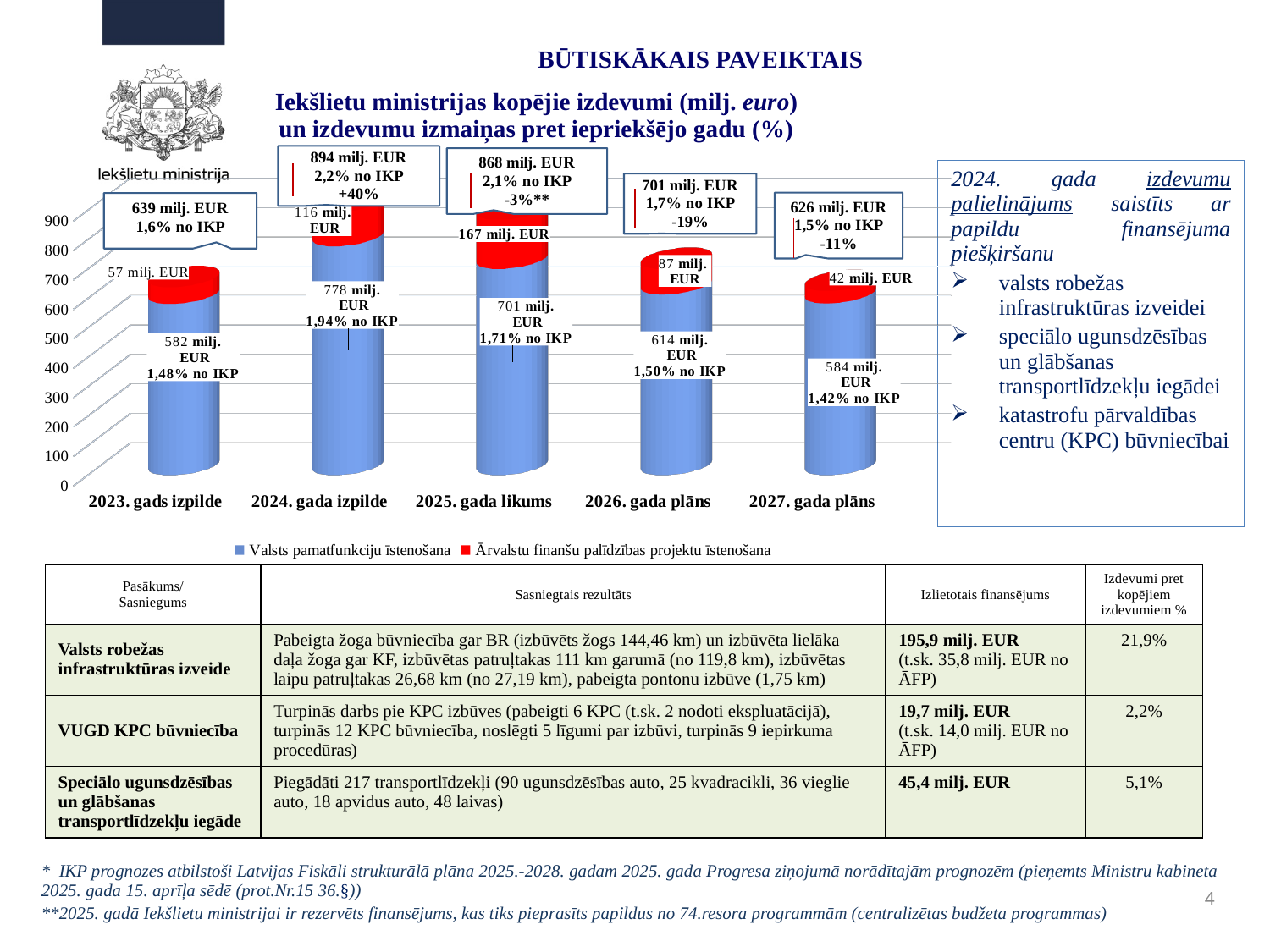
What is the total expenditure shown for 2027. gada plāns? 626 milj. EUR What is the value of Ārvalstu finanšu palīdzības projektu īstenošana for 2025. gada likums? 167 milj. EUR How many categories (years) are shown on the x axis of the chart? 5 Which year has the highest total expenditure in the chart? 2024. gada izpilde What percentage change versus the previous year is shown for 2026. gada plāns? -19% What is the value of Valsts pamatfunkciju īstenošana for 2024. gada izpilde? 778 milj. EUR Which is larger: the Ārvalstu finanšu palīdzības projektu īstenošana value for 2024. gada izpilde or for 2026. gada plāns? 2024. gada izpilde What is the difference between the Valsts pamatfunkciju īstenošana values for 2024. gada izpilde and 2023. gads izpilde? 196 milj. EUR Which colour represents Ārvalstu finanšu palīdzības projektu īstenošana in the chart? red Which year has the lowest value for Ārvalstu finanšu palīdzības projektu īstenošana? 2027. gada plāns How many series does the chart legend list? 2 What kind of chart is shown on the slide? bar chart